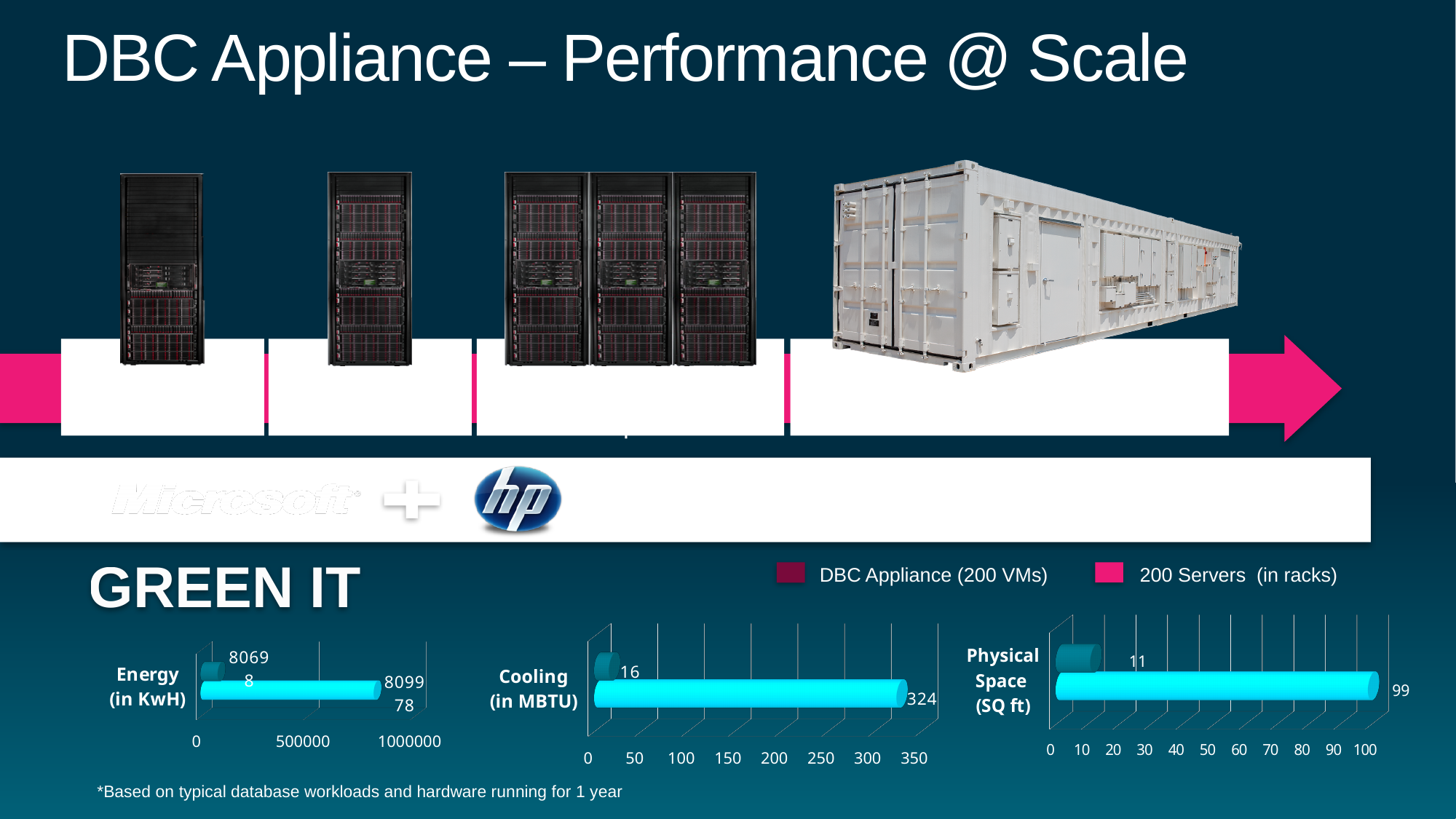
In the Physical Space (SQ ft) chart, which series has the larger value, DBC Appliance (200 VMs) or 200 Servers (in racks)? 200 Servers (in racks) In the Energy (in KwH) chart, is the value for 200 Servers (in racks) greater or less than 500000? greater In the Cooling (in MBTU) chart, what is the difference between the 200 Servers value and the DBC Appliance value? 308 How many series does the legend above the Green IT charts list? 2 In the Cooling (in MBTU) chart, what is the value for 200 Servers (in racks)? 324 In the Energy (in KwH) chart, is the value for DBC Appliance (200 VMs) greater or less than 500000? less In the Physical Space (SQ ft) chart, what is the value for 200 Servers (in racks)? 99 In the Physical Space (SQ ft) chart, what is the difference between the 200 Servers value and the DBC Appliance value? 88 In the Cooling (in MBTU) chart, what is the value for DBC Appliance (200 VMs)? 16 What kind of chart is the Cooling (in MBTU) chart? bar chart In the Physical Space (SQ ft) chart, what is the value for DBC Appliance (200 VMs)? 11 In the Cooling (in MBTU) chart, which series has the lowest value? DBC Appliance (200 VMs)